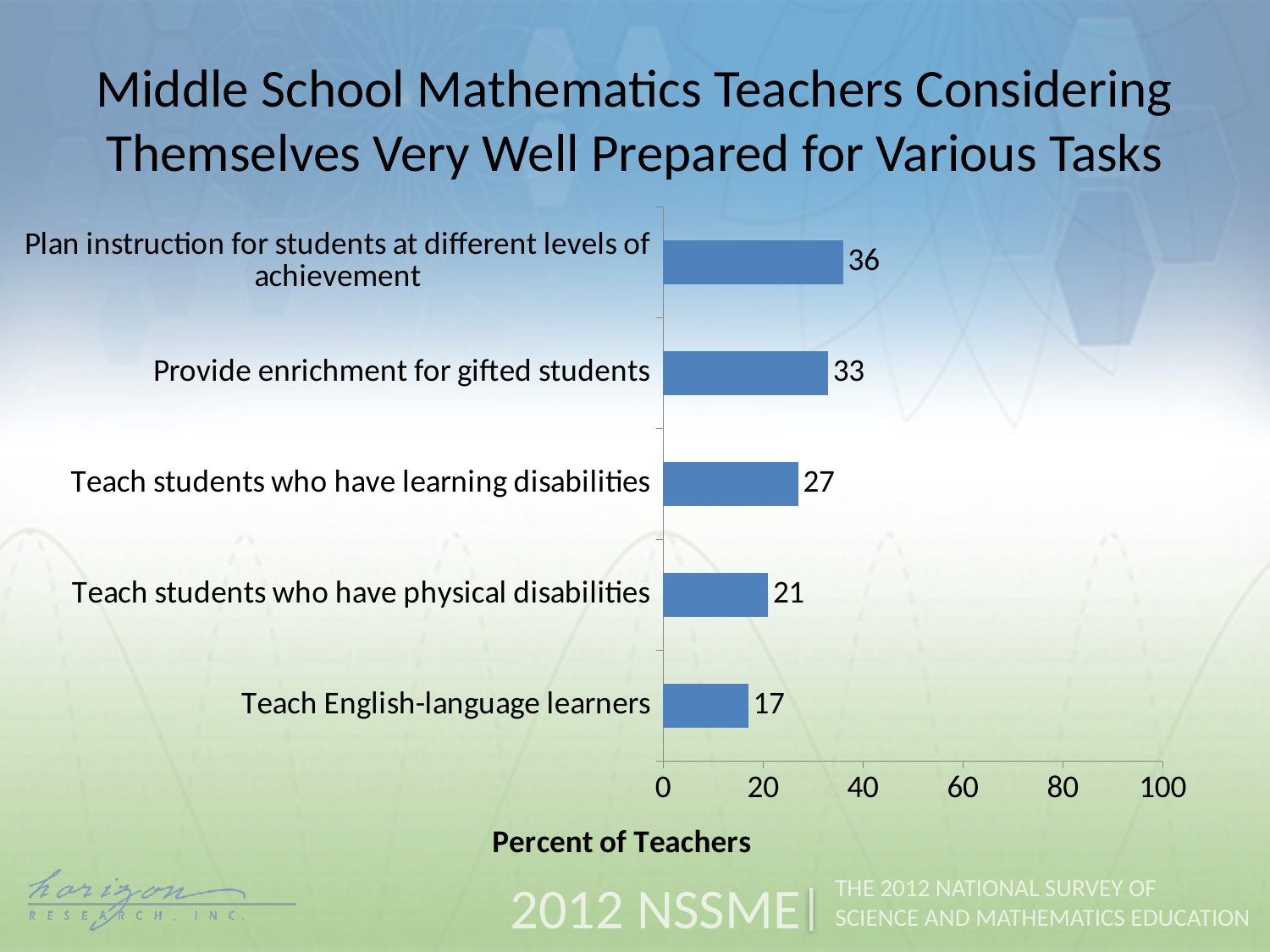
Is the value for "Provide enrichment for gifted students" greater or less than 40? less What is the maximum value shown on the horizontal axis? 100 What kind of chart is shown on the slide? Bar chart What is the difference between the values for "Provide enrichment for gifted students" and "Teach students who have learning disabilities"? 6 What is the value for "Teach English-language learners"? 17 Which is larger: the value for "Teach students who have learning disabilities" or "Teach students who have physical disabilities"? Teach students who have learning disabilities Which task has the highest percent of teachers feeling very well prepared? Plan instruction for students at different levels of achievement What percent of middle school mathematics teachers consider themselves very well prepared to plan instruction for students at different levels of achievement? 36 Which task has the lowest percent of teachers feeling very well prepared? Teach English-language learners How many tasks are shown in the chart? 5 What is the label of the horizontal axis? Percent of Teachers What is the value for "Teach students who have physical disabilities"? 21